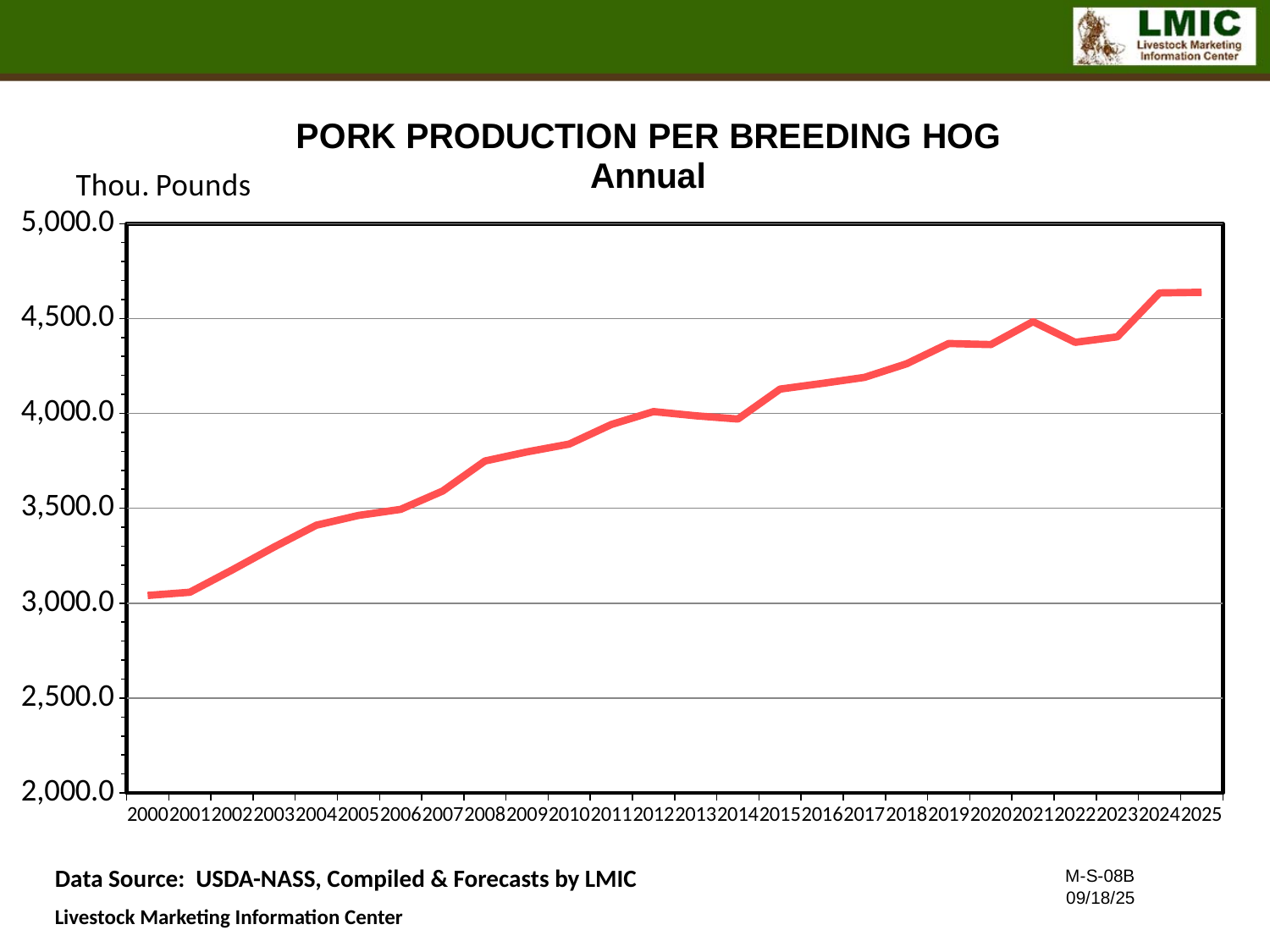
How many years are plotted along the x axis? 26 What kind of chart is shown on the slide? line chart Which year has the larger value, 2021 or 2022? 2021 What is the title of the chart? PORK PRODUCTION PER BREEDING HOG Annual Is the value for 2015 greater or less than 4,000.0? greater Is the value for 2003 greater or less than 3,500.0? less Is the value for 2018 greater or less than 4,500.0? less What unit is shown on the vertical axis label? Thou. Pounds Do the values generally rise or fall from 2000 to 2025? rise